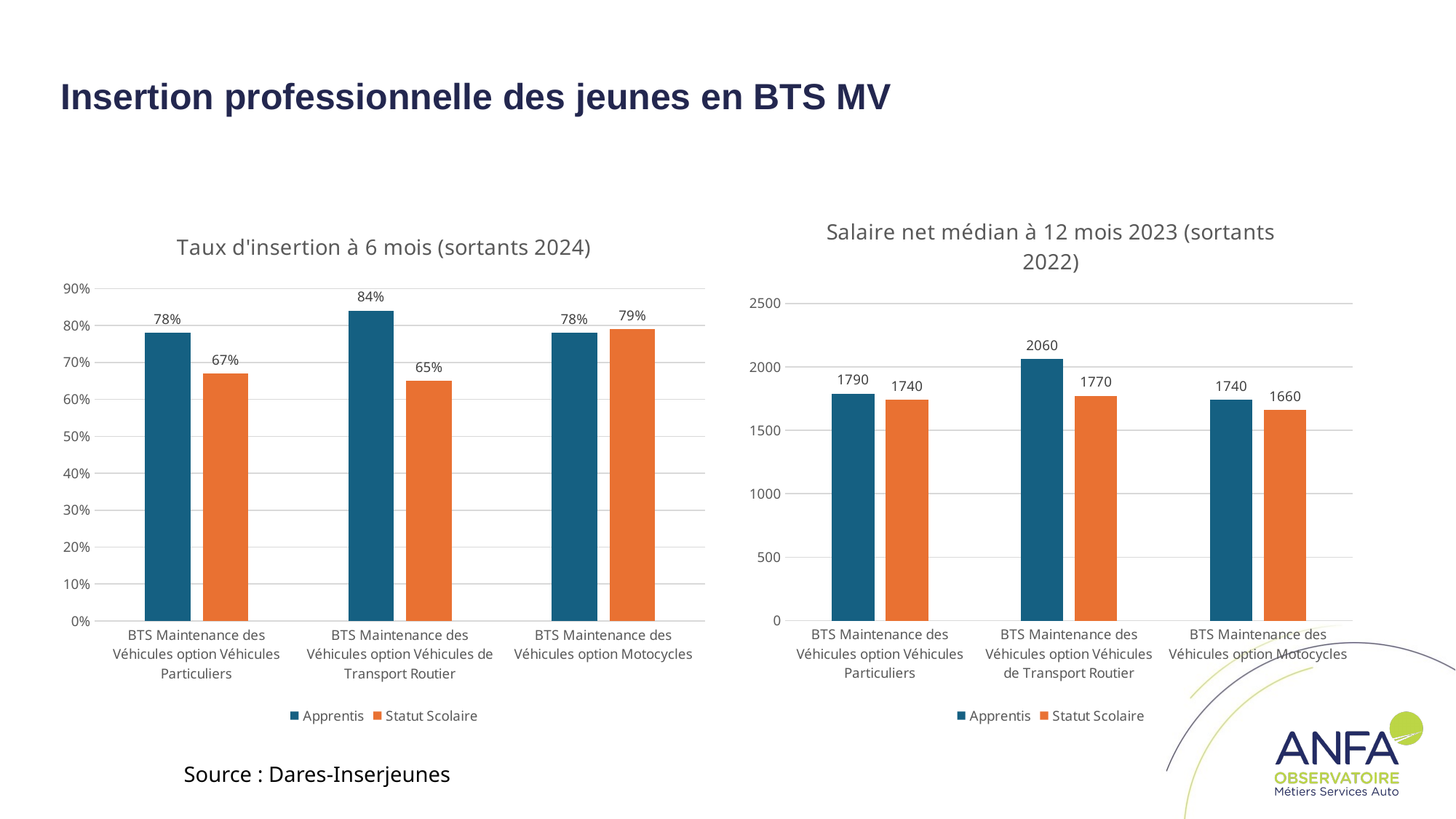
In the chart 'Taux d'insertion à 6 mois (sortants 2024)', what is the value for Apprentis in BTS Maintenance des Véhicules option Véhicules de Transport Routier? 84% In the chart 'Salaire net médian à 12 mois 2023 (sortants 2022)', which category has the highest Apprentis value? BTS Maintenance des Véhicules option Véhicules de Transport Routier In the chart 'Taux d'insertion à 6 mois (sortants 2024)', what is the difference between Apprentis and Statut Scolaire for BTS Maintenance des Véhicules option Véhicules de Transport Routier? 19% What kind of chart is 'Taux d'insertion à 6 mois (sortants 2024)'? Bar chart How many categories are shown on the x axis of the chart 'Salaire net médian à 12 mois 2023 (sortants 2022)'? 3 In the chart 'Taux d'insertion à 6 mois (sortants 2024)', what is the value for Statut Scolaire in BTS Maintenance des Véhicules option Motocycles? 79% In the chart 'Taux d'insertion à 6 mois (sortants 2024)', how many series does the legend list? 2 In the chart 'Salaire net médian à 12 mois 2023 (sortants 2022)', is the Apprentis value for BTS Maintenance des Véhicules option Véhicules de Transport Routier greater or less than 2000? greater In the chart 'Salaire net médian à 12 mois 2023 (sortants 2022)', what is the value for Apprentis in BTS Maintenance des Véhicules option Véhicules Particuliers? 1790 In the chart 'Salaire net médian à 12 mois 2023 (sortants 2022)', which is larger for BTS Maintenance des Véhicules option Motocycles: Apprentis or Statut Scolaire? Apprentis In the chart 'Salaire net médian à 12 mois 2023 (sortants 2022)', what is the difference between Apprentis and Statut Scolaire for BTS Maintenance des Véhicules option Véhicules de Transport Routier? 290 In the chart 'Taux d'insertion à 6 mois (sortants 2024)', which category has the lowest Statut Scolaire value? BTS Maintenance des Véhicules option Véhicules de Transport Routier